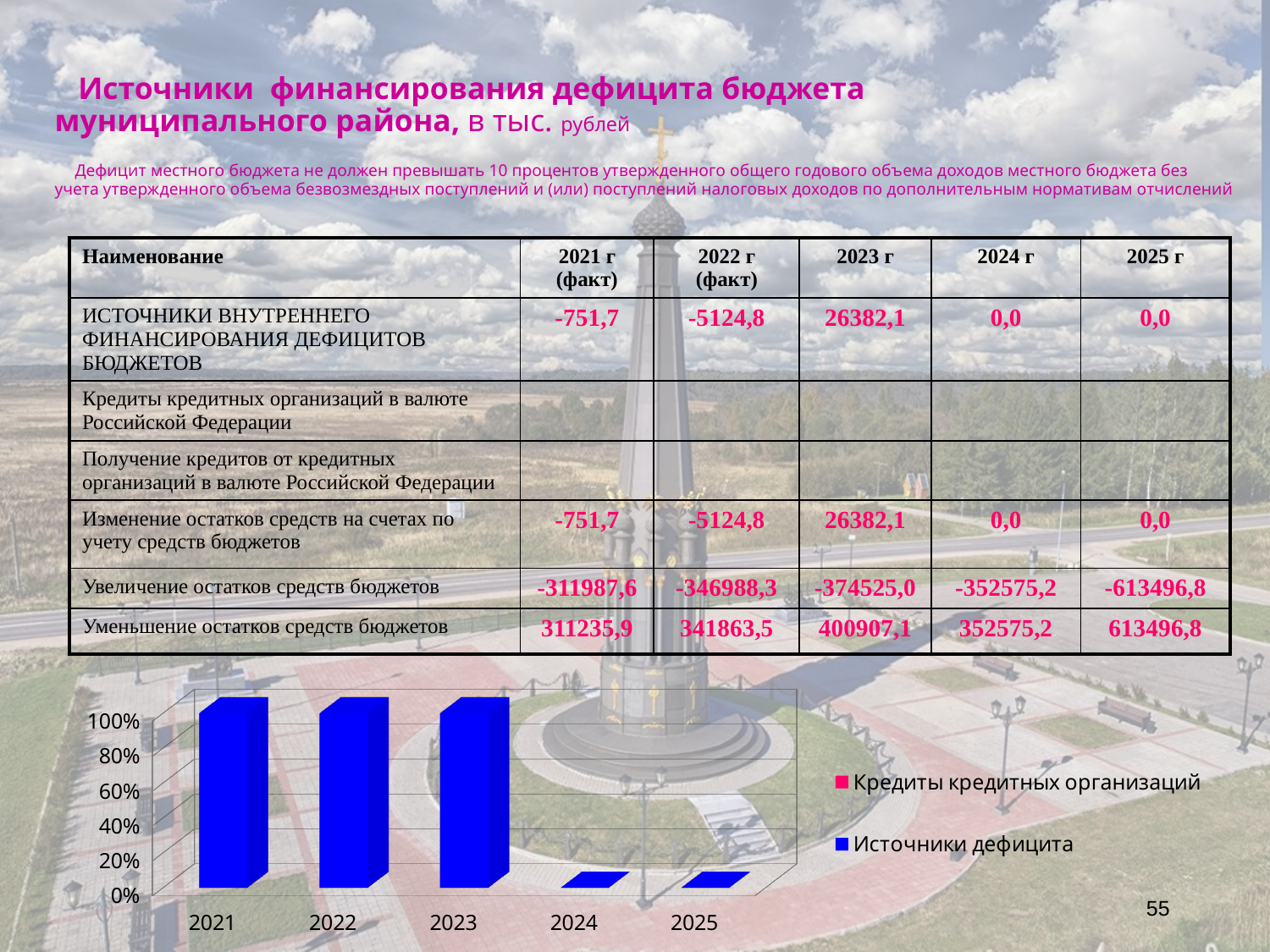
Which series is shown in blue in the bar chart? Источники дефицита In the bar chart, which is larger, the bar for 2023 or the bar for 2025? 2023 How many series does the legend of the bar chart list? 2 How many categories are shown on the x axis of the bar chart? 5 In the bar chart, is the value for 2024 greater or less than 20%? less In the bar chart, is the value for 2025 greater or less than 20%? less In the bar chart, is the value for 2023 greater or less than 60%? greater What kind of chart is shown at the bottom of the slide? bar chart What is the first category on the x axis of the bar chart? 2021 In the bar chart, which is larger, the bar for 2022 or the bar for 2024? 2022 Which series is shown in pink in the bar chart legend? Кредиты кредитных организаций